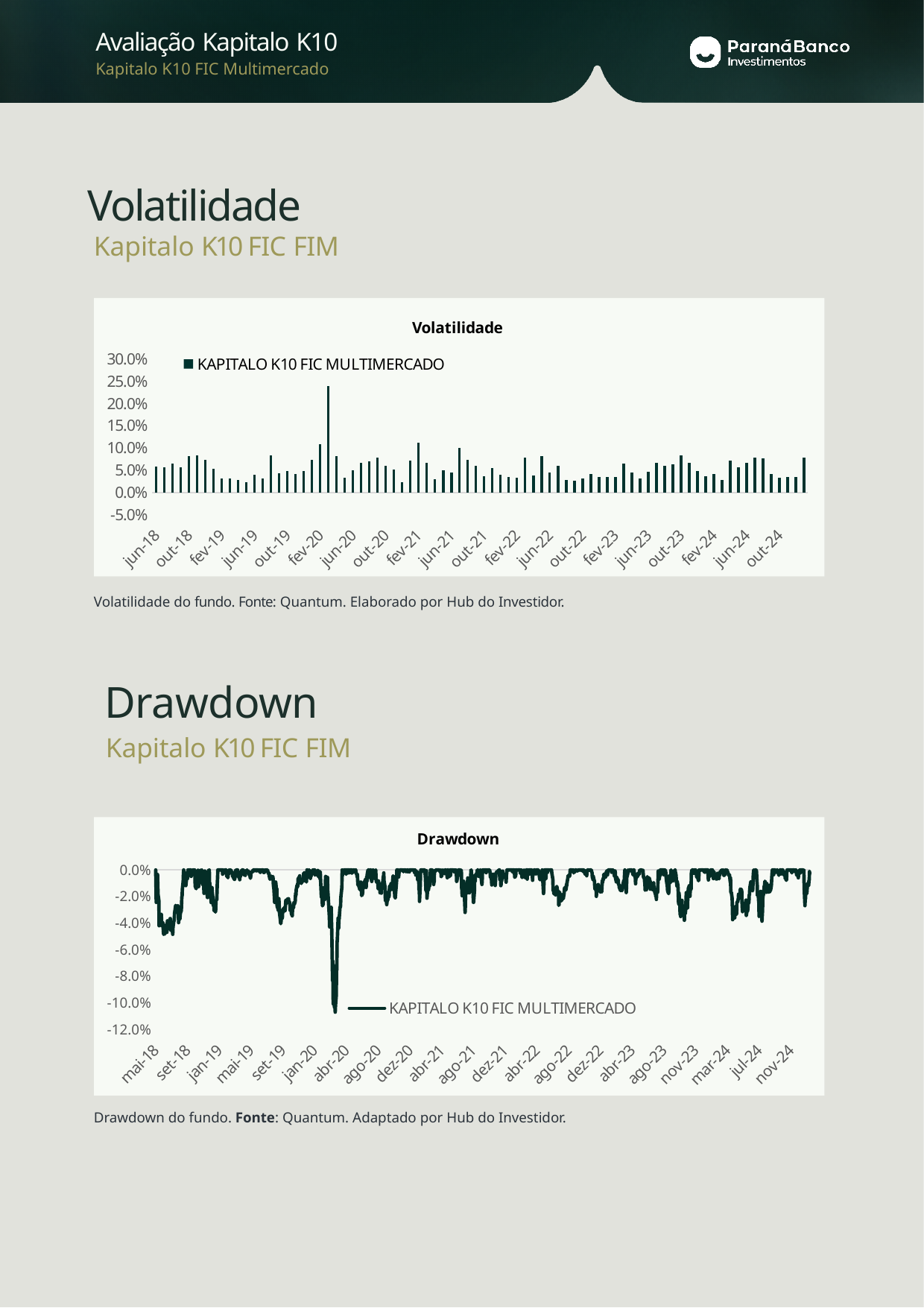
In the Drawdown chart, around which x-axis label does the deepest drawdown occur? abr-20 What kind of chart is the Volatilidade chart? bar chart In the Volatilidade chart, is the highest bar greater or less than 20.0%? greater What is the lowest value shown on the y axis of the Drawdown chart? -12.0% How many series does the legend of the Volatilidade chart list? 1 In the Volatilidade chart, is the value for jun-18 greater or less than 10.0%? less In the Drawdown chart, is the lowest point of the line greater or less than -8.0%? less In the Volatilidade chart, what is the name of the series shown in the legend? KAPITALO K10 FIC MULTIMERCADO What kind of chart is the Drawdown chart? line chart In the Volatilidade chart, around which x-axis label does the highest bar occur? fev-20 How many series does the legend of the Drawdown chart list? 1